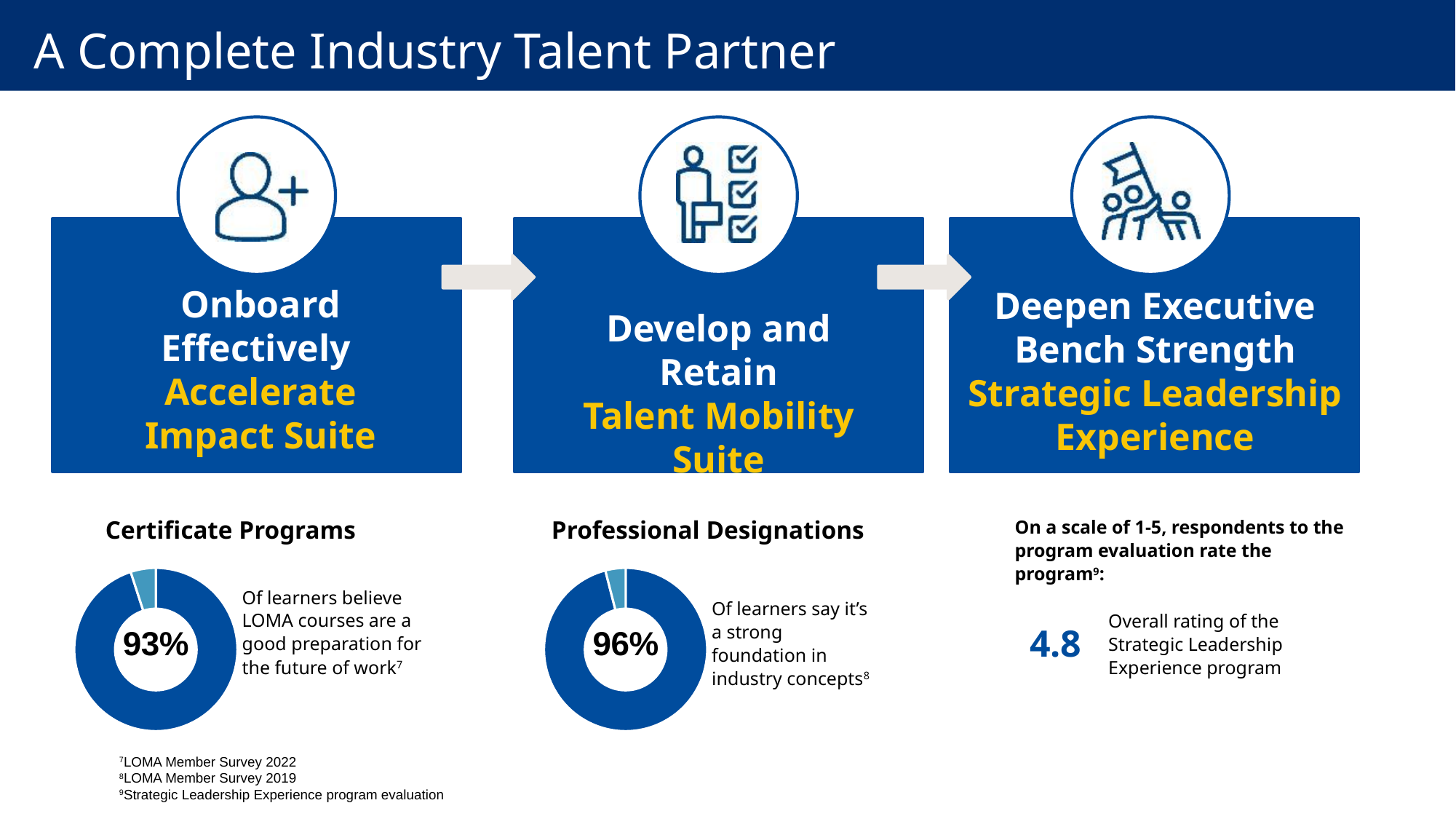
What kind of chart is used under the Certificate Programs heading? Donut chart In the Professional Designations donut chart, what share of the ring does the large dark blue segment represent? 96% In the Certificate Programs donut chart, what percentage is shown in the centre? 93% How many donut charts are shown on the slide? 2 What is the heading above the donut chart showing 96%? Professional Designations What is the difference in percentage points between the Professional Designations value and the Certificate Programs value? 3 percentage points Is the value shown in the Certificate Programs donut chart greater or less than 90%? greater What colour is the small segment in the Certificate Programs donut chart? Light blue In the Professional Designations donut chart, what percentage is shown in the centre? 96% Which donut chart shows the larger percentage, Certificate Programs or Professional Designations? Professional Designations